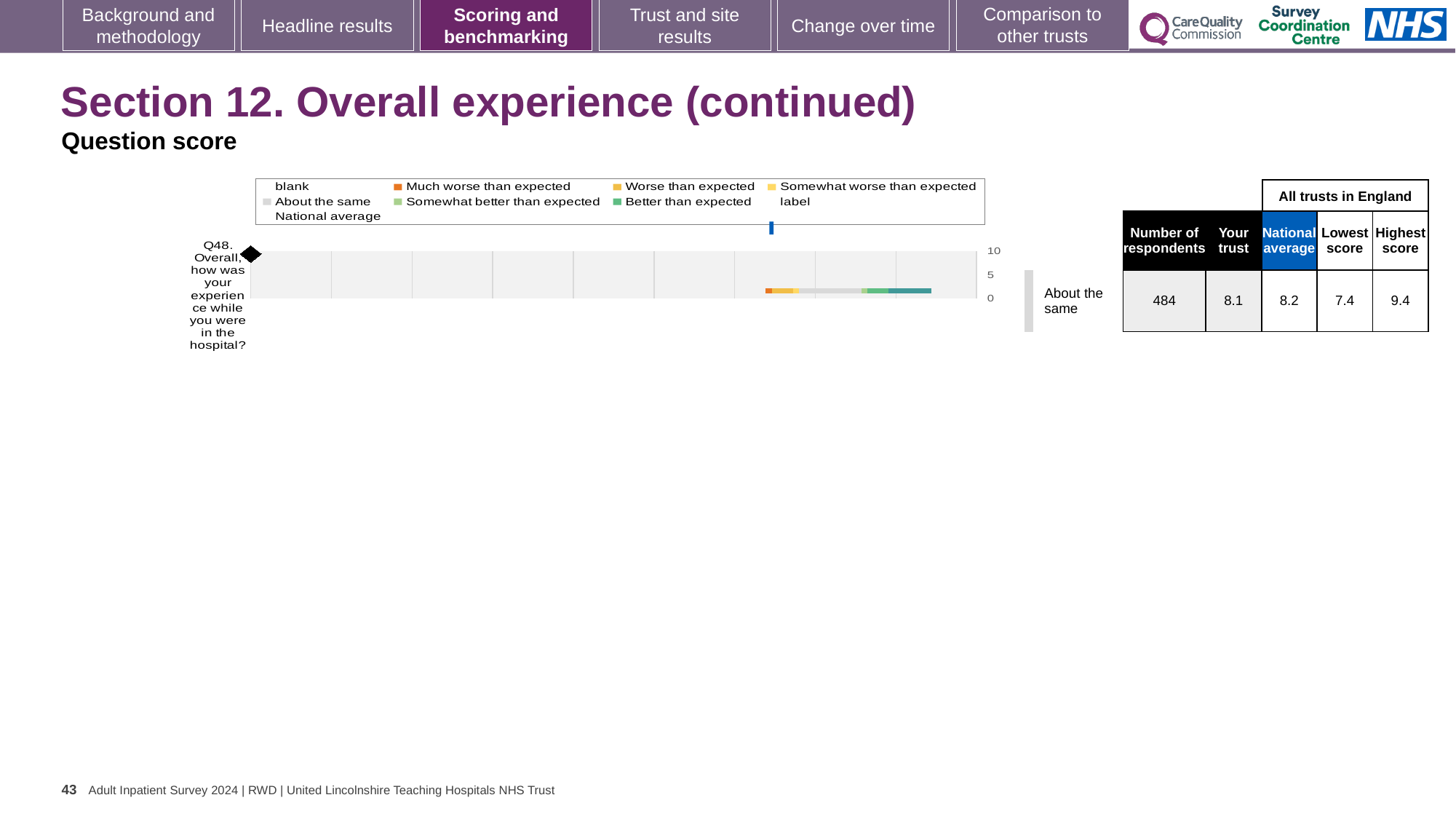
Which is larger for Q48: the trust's score or the national average? National average What is the lowest score among all trusts in England for Q48? 7.4 What is the difference between the highest score and the lowest score for Q48 across all trusts in England? 2.0 What is the trust's score for Q48 'Overall, how was your experience while you were in the hospital?' shown in the 'Your trust' column? 8.1 How many respondents answered Q48 according to the table? 484 What is the maximum value shown on the chart's score axis? 10 What benchmarking category is the trust's Q48 result placed in? About the same Which legend entry is shown with a dark orange colour? Much worse than expected What is the difference between the national average and the trust's score for Q48? 0.1 What is the national average score for Q48 shown in the table? 8.2 How many questions are plotted on the chart? 1 What is the highest score among all trusts in England for Q48? 9.4